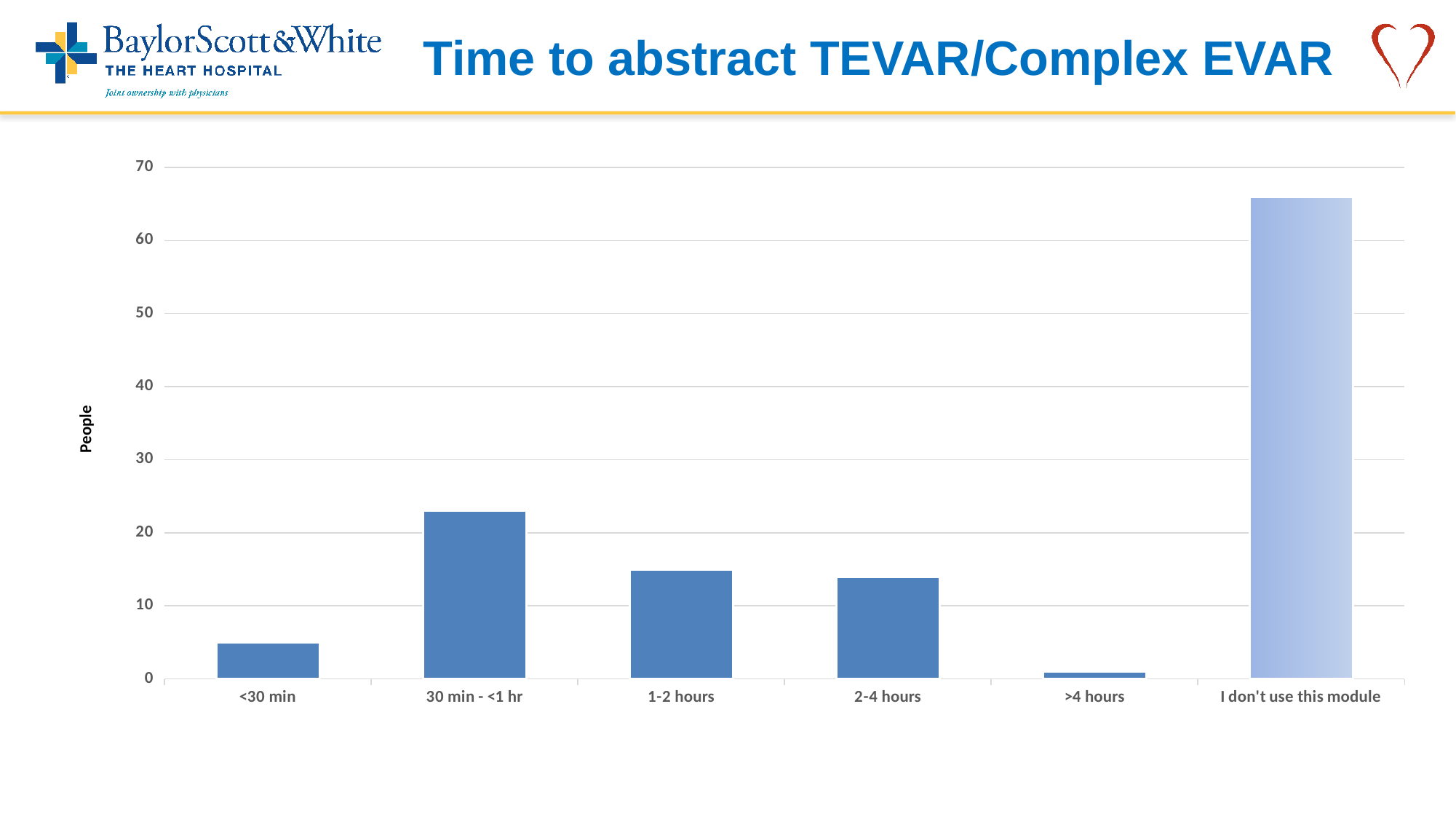
What kind of chart is shown on the slide? bar chart Is the value for "<30 min" greater or less than 10? less Which is larger, the value for "30 min - <1 hr" or the value for "<30 min"? 30 min - <1 hr Is the value for ">4 hours" greater or less than 10? less Which is larger, the value for "2-4 hours" or the value for ">4 hours"? 2-4 hours Is the value for "30 min - <1 hr" greater or less than 20? greater How many categories are shown on the x axis of the chart? 6 What is the label on the y axis of the chart? People Which category has the highest value? I don't use this module Which category has the lowest value? >4 hours